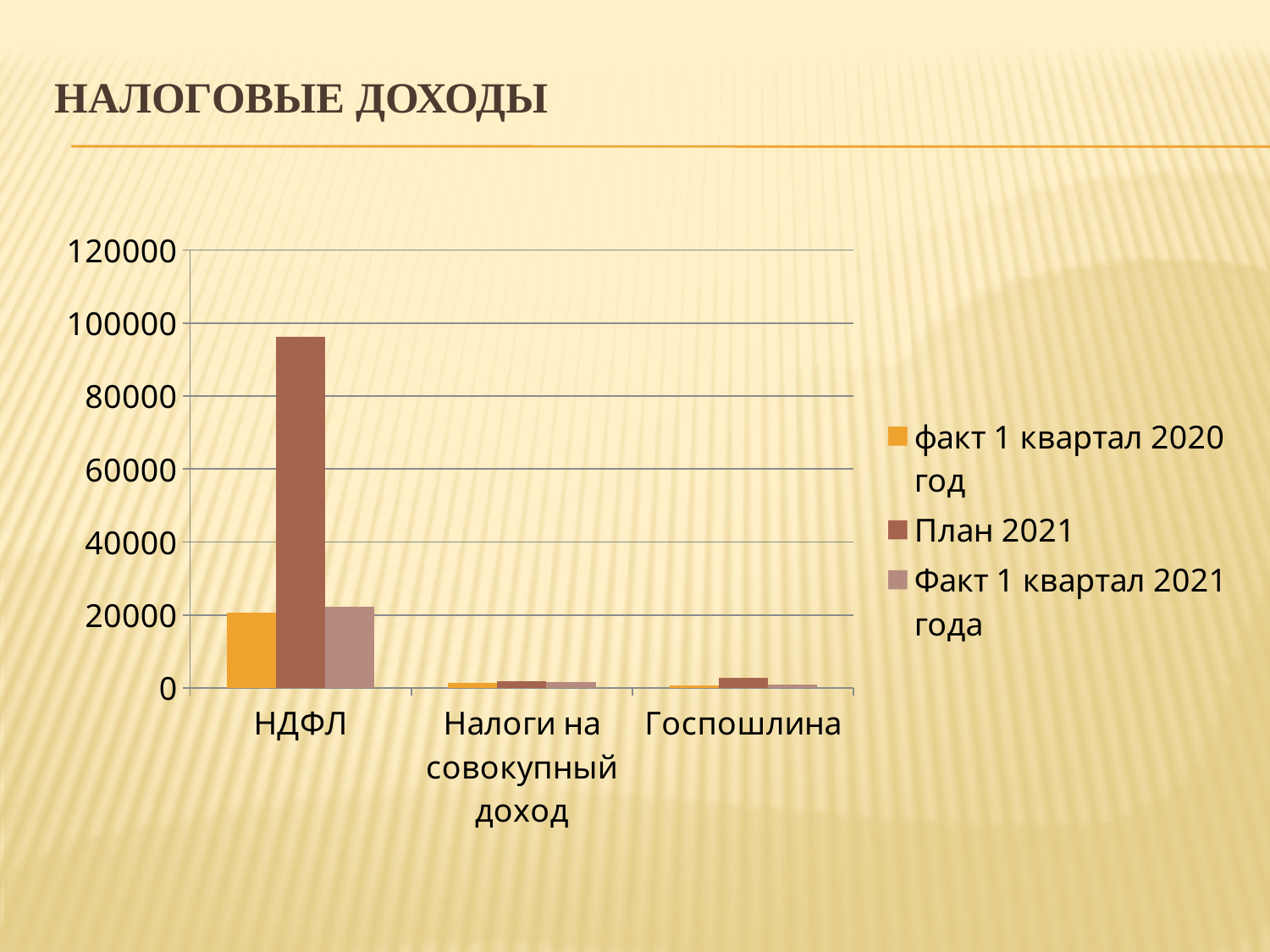
Is the value of План 2021 for НДФЛ greater or less than 80000? greater What kind of chart is shown on the slide? bar chart Which category has the highest value for the series План 2021? НДФЛ Which series is shown in orange in the legend? факт 1 квартал 2020 год Is the value of факт 1 квартал 2020 год for НДФЛ greater or less than 40000? less How many categories are shown on the x axis of the chart? 3 Which category has the lowest value for the series План 2021? Налоги на совокупный доход For НДФЛ, which is larger: План 2021 or факт 1 квартал 2020 год? План 2021 Is the value of Факт 1 квартал 2021 года for НДФЛ greater or less than 40000? less What is the title of the slide? НАЛОГОВЫЕ ДОХОДЫ How many series does the legend list? 3